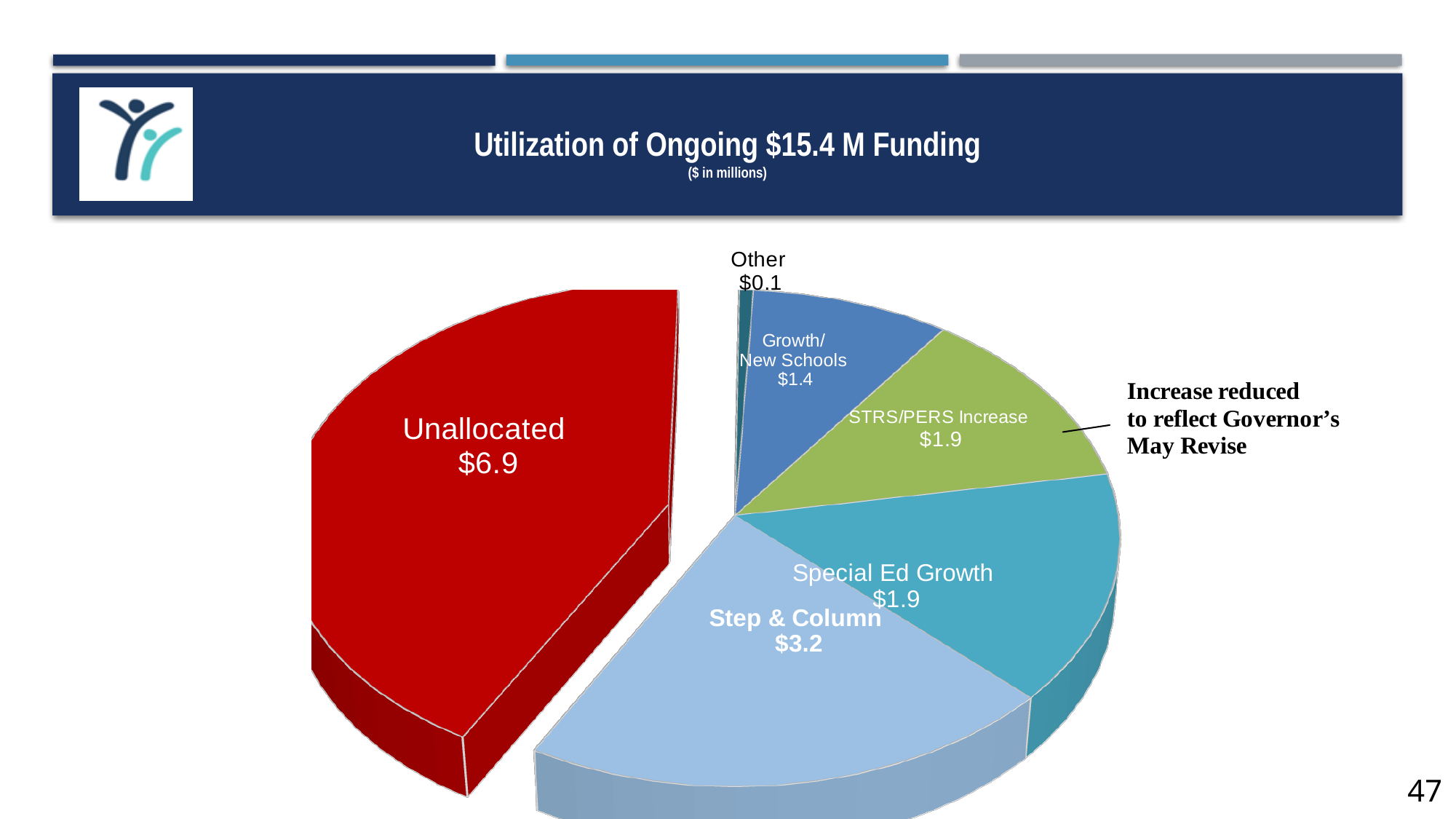
How many slices does the pie chart have? 6 What is the value of the Unallocated slice? $6.9 Which category has the largest slice of the pie? Unallocated What is the value of the Step & Column slice? $3.2 What type of chart is shown on the slide? Pie chart What is the title of the chart? Utilization of Ongoing $15.4 M Funding What is the value of the STRS/PERS Increase slice? $1.9 Which category has the smallest slice of the pie? Other What is the value of the Growth/New Schools slice? $1.4 What is the difference between the Unallocated and Step & Column values? $3.7 Which is larger, Step & Column or Special Ed Growth? Step & Column What is the value of the Other slice? $0.1